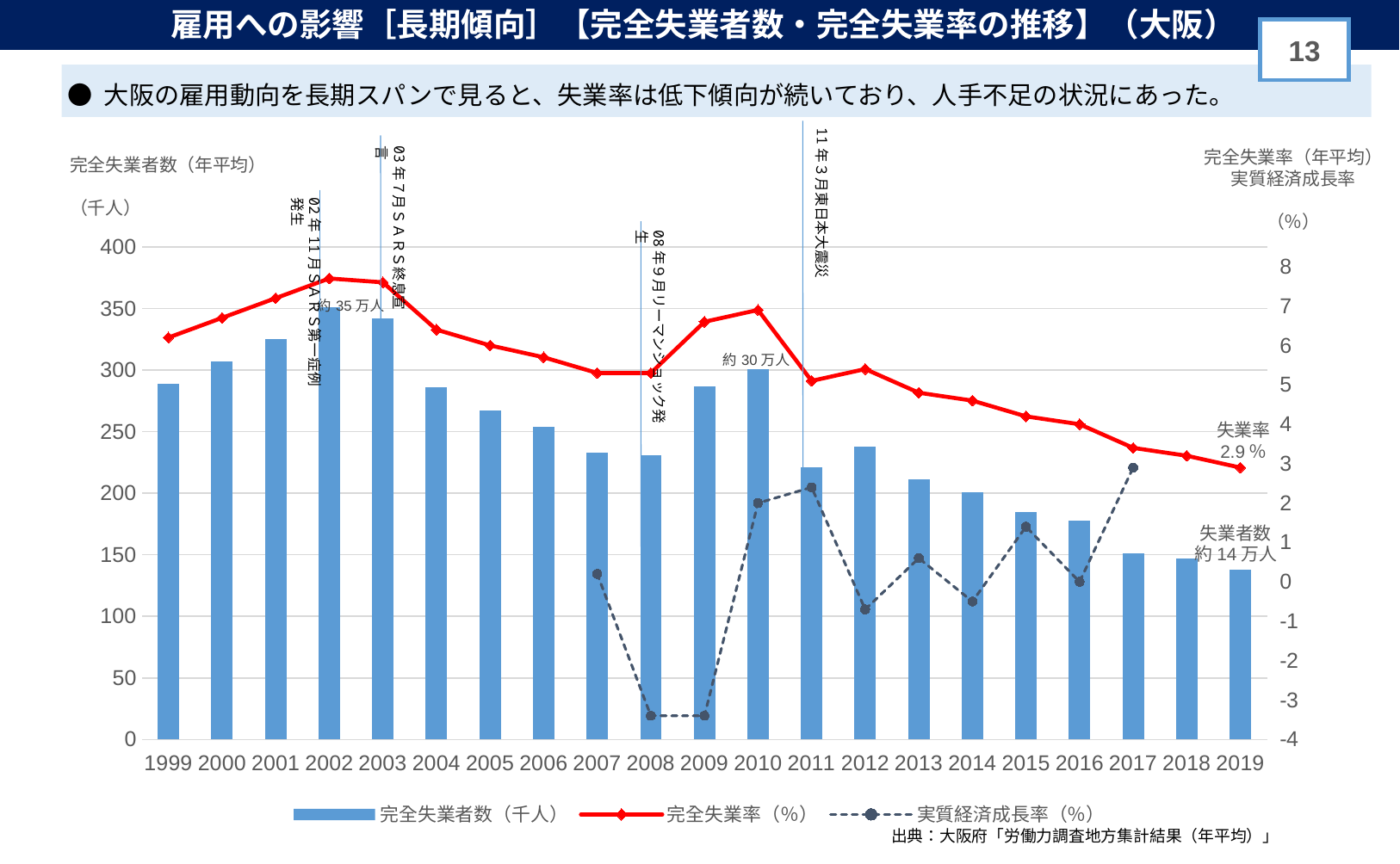
Is the 完全失業者数 bar for 1999 greater or less than 250? greater How many years are shown along the x axis? 21 Which year has the highest point on the dashed 実質経済成長率 line? 2017 How many series does the legend list? 3 Which year has the lowest bar for 完全失業者数? 2019 Is the 完全失業者数 bar for 2019 greater or less than 150? less Which is larger, the 完全失業者数 bar for 2009 or for 2008? 2009 Does the 完全失業率 line rise or fall from 2010 to 2019? It falls What kind of chart is shown on the slide? A combination bar and line chart Is the 実質経済成長率 value for 2008 greater or less than -2 on the right axis? less What unemployment rate (失業率) is annotated at the right end of the red line? 2.9％